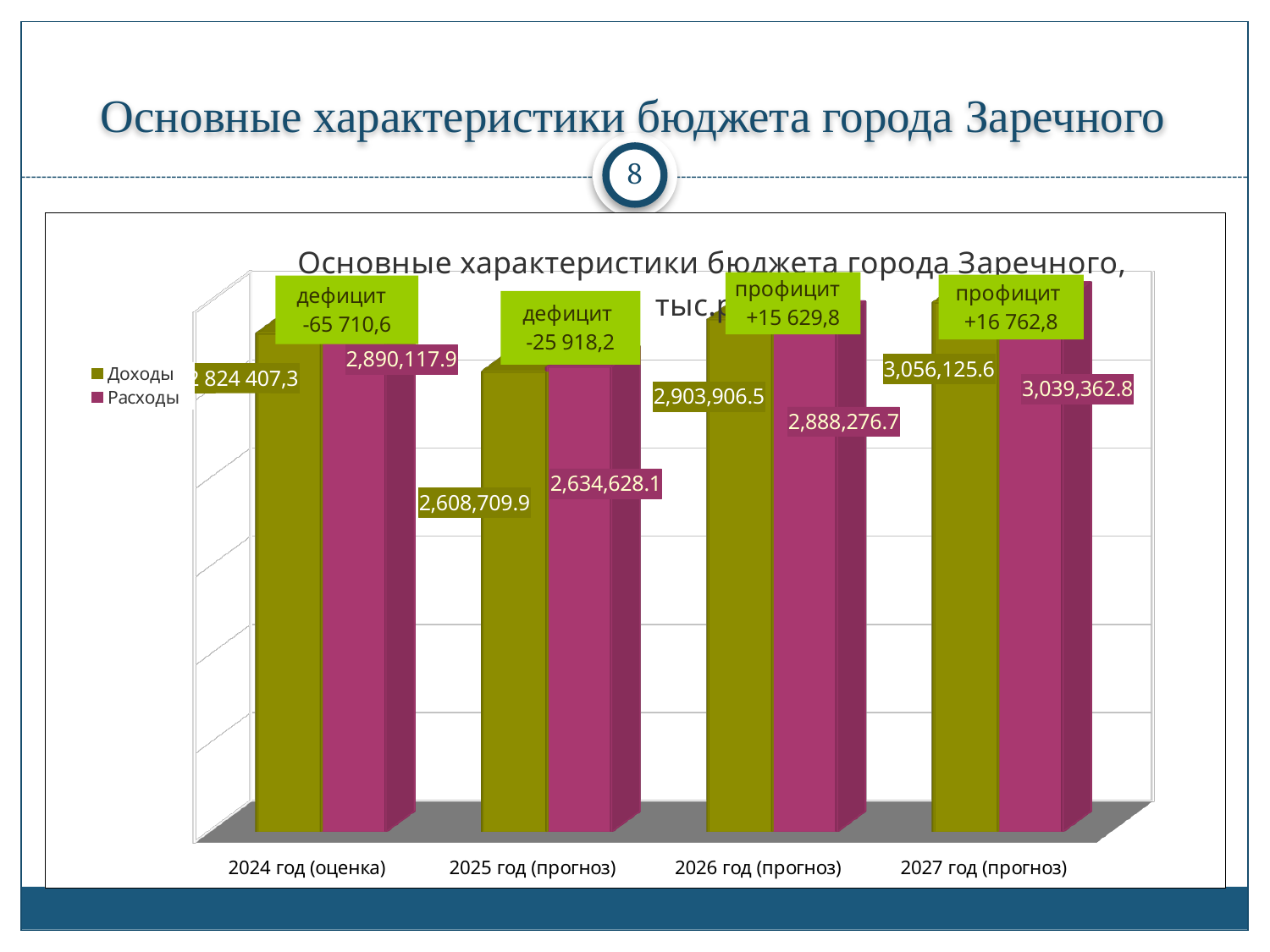
Which year has the highest value for Доходы? 2027 год (прогноз) How many series does the legend list? 2 What is the value of Доходы for 2026 год (прогноз)? 2,903,906.5 What is the difference between Доходы and Расходы for 2027 год (прогноз)? 16,762.8 How many year categories are shown on the x axis? 4 What is the value of Расходы for 2027 год (прогноз)? 3,039,362.8 What is the value of Расходы for 2025 год (прогноз)? 2,634,628.1 Do the Доходы values rise or fall from 2025 год (прогноз) to 2027 год (прогноз)? Rise What kind of chart is shown on the slide? Bar chart For 2026 год (прогноз), which is larger: Доходы or Расходы? Доходы Which year has the lowest value for Расходы? 2025 год (прогноз) What is the value of Доходы for 2025 год (прогноз)? 2,608,709.9